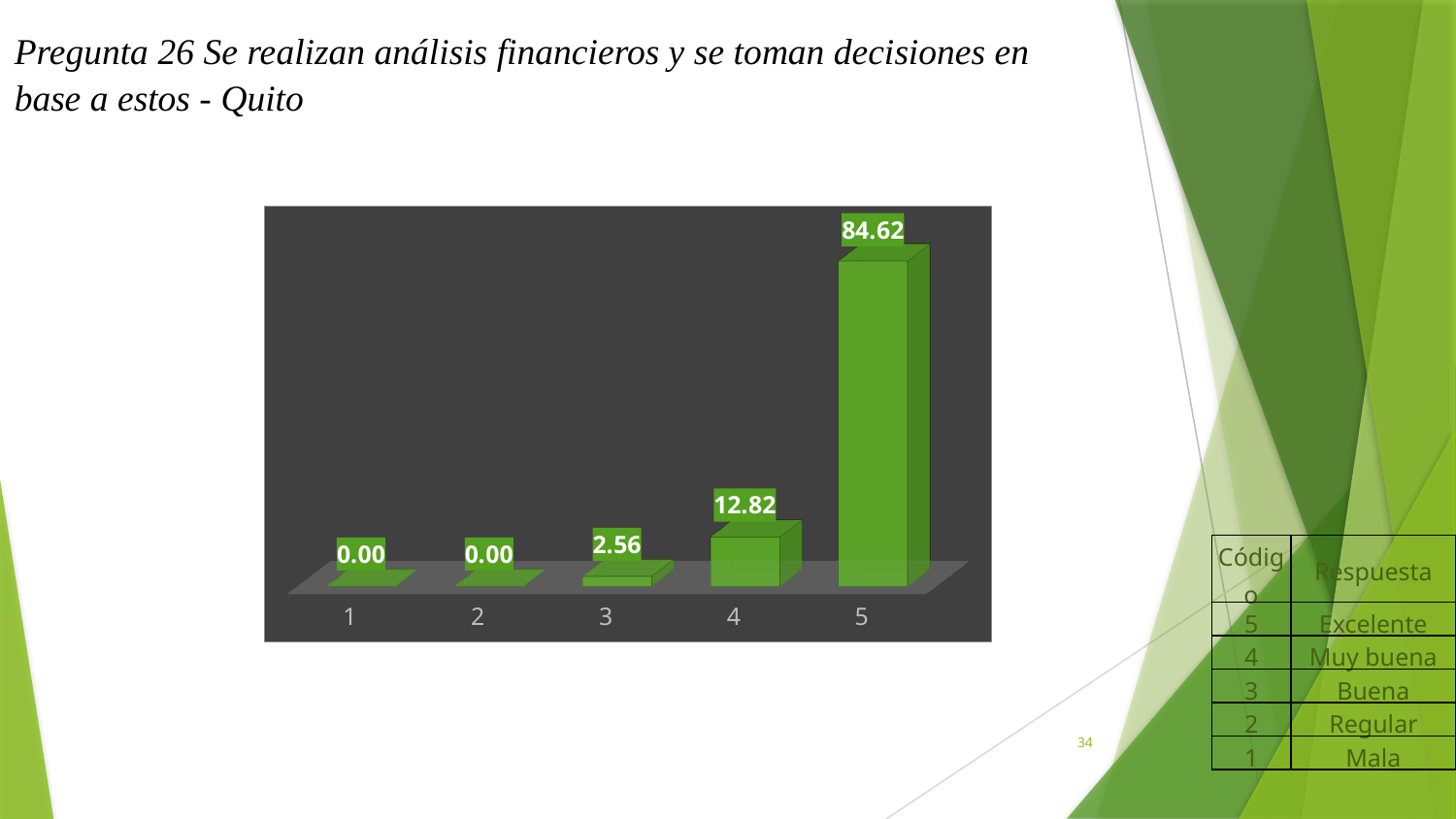
What is the value for category 5? 84.62 What kind of chart is shown? bar chart How many categories are shown on the x axis? 5 What is the value for category 4? 12.82 Which category has the highest value? 5 What is the difference between the values for category 4 and category 3? 10.26 What is the value for category 3? 2.56 What is the value for category 1? 0.00 Which is larger, the value for category 3 or the value for category 4? 4 What is the difference between the values for category 5 and category 4? 71.80 Do the values rise or fall from category 1 to category 5? rise What colour are the bars in the chart? green